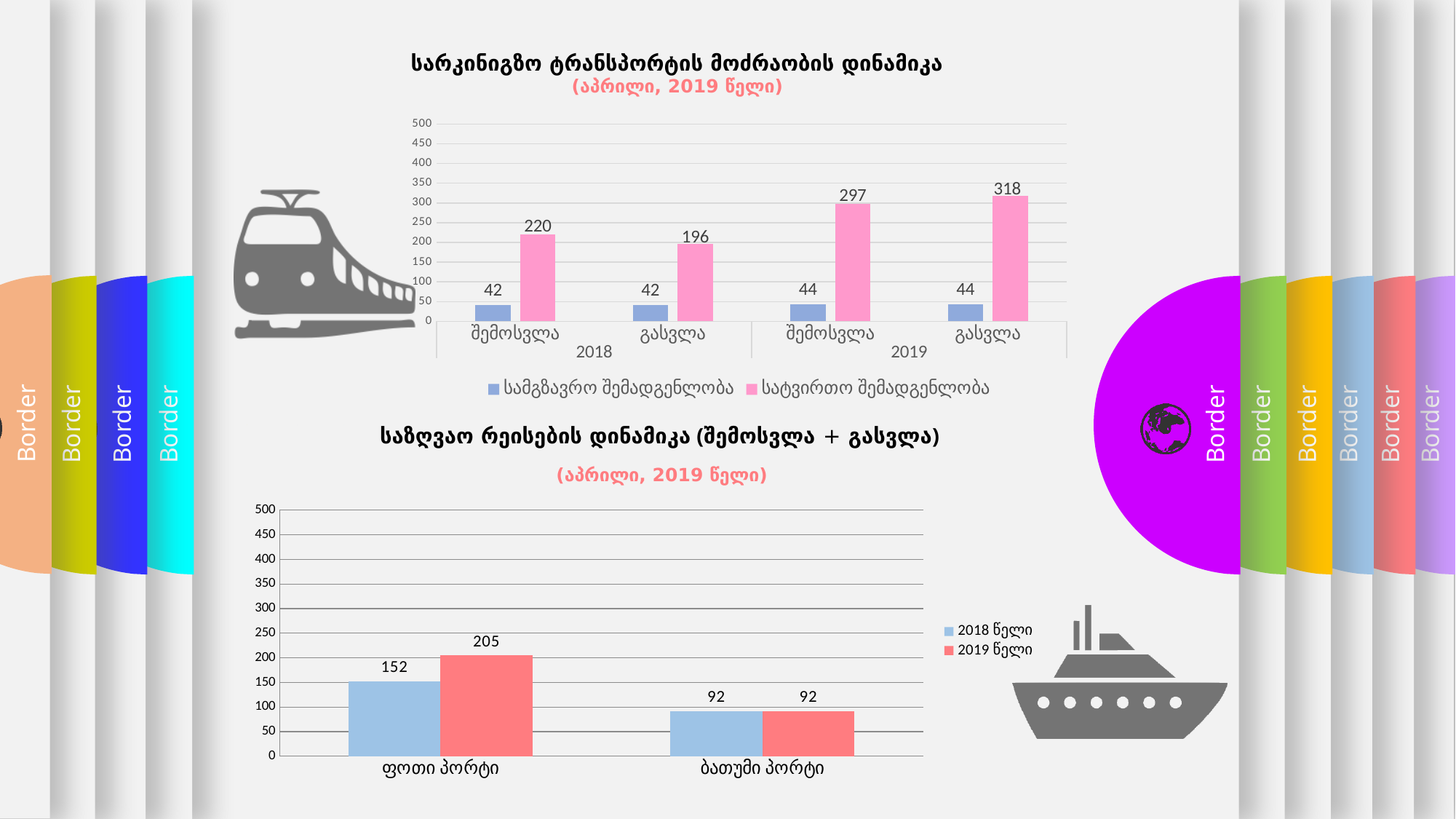
In the top chart, what is the value of სამგზავრო შემადგენლობა for გასვლა in 2018? 42 In the top chart, what is the difference between the სატვირთო შემადგენლობა values for გასვლა in 2019 and გასვლა in 2018? 122 In the bottom chart, which is larger: the 2018 წელი value for ფოთი პორტი or the 2018 წელი value for ბათუმი პორტი? ფოთი პორტი In the top chart, how many series does the legend list? 2 In the bottom chart, what is the difference between the 2019 წელი and 2018 წელი values for ფოთი პორტი? 53 In the bottom chart, what is the value for ბათუმი პორტი in 2018 წელი? 92 In the bottom chart (საზღვაო რეისების დინამიკა), what is the value for ფოთი პორტი in 2019 წელი? 205 In the top chart (სარკინიგზო ტრანსპორტის მოძრაობის დინამიკა), what is the value of სატვირთო შემადგენლობა for შემოსვლა in 2019? 297 What type of chart is the bottom chart? bar chart In the bottom chart, how many port categories are shown on the x axis? 2 In the top chart, which category has the highest სატვირთო შემადგენლობა value? გასვლა 2019 In the top chart, is the სატვირთო შემადგენლობა value for შემოსვლა in 2018 greater or less than 200? greater